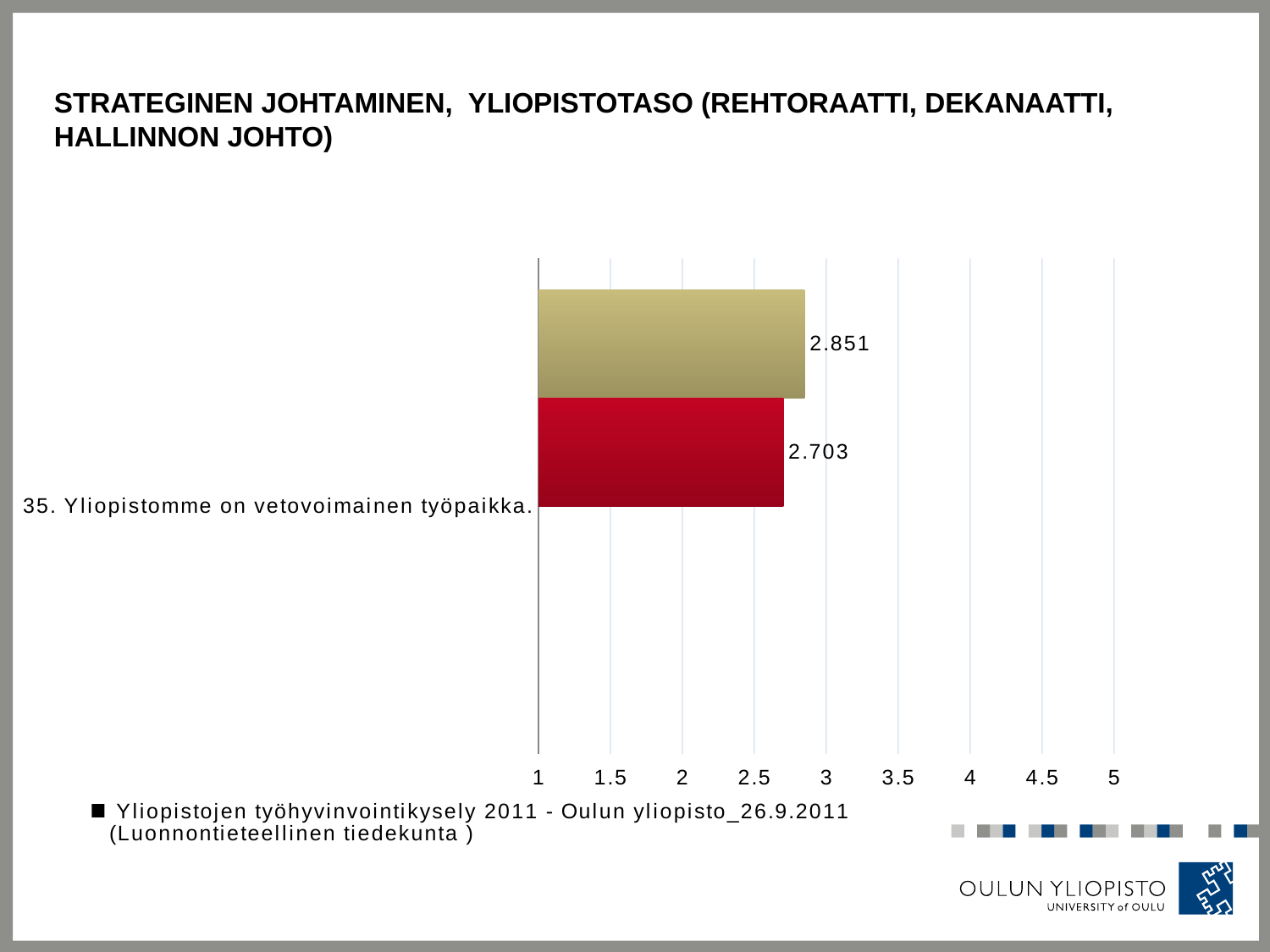
What is the value shown on the red (lower) bar? 2.703 What is the lowest value plotted on the chart? 2.703 Is the value of the red bar (2.703) greater or less than 2.5? greater What is the value shown on the tan (upper) bar? 2.851 What kind of chart is shown on the slide? Bar chart Which bar has the larger value, the upper tan bar or the lower red bar? The upper tan bar (2.851) How many entries does the chart legend list? 1 What is the category label shown on the chart's vertical axis? 35. Yliopistomme on vetovoimainen työpaikka. What is the highest value plotted on the chart? 2.851 How many bars are plotted on the chart? 2 What is the difference between the two bar values, 2.851 and 2.703? 0.148 Is the value of the tan bar (2.851) greater or less than 3? less